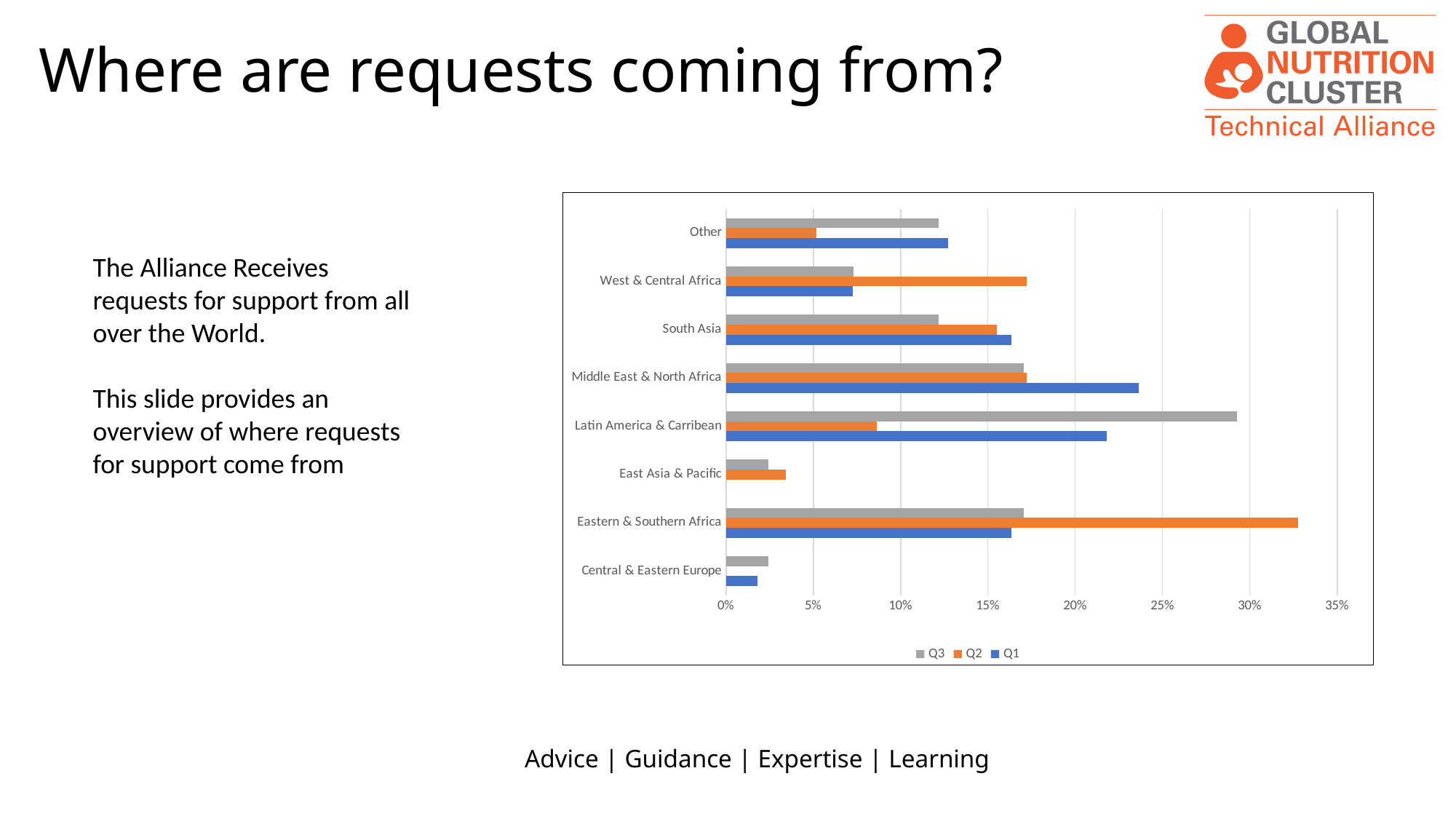
Is the Q1 value for Middle East & North Africa greater or less than 20%? greater Is the Q2 value for Eastern & Southern Africa greater or less than 30%? greater Which region has the highest Q1 value? Middle East & North Africa Which region has the highest Q3 value? Latin America & Carribean Is the Q3 value for Latin America & Carribean greater or less than 25%? greater For Other, which is larger: the Q1 value or the Q2 value? Q1 What are the entries listed in the chart's legend? Q3, Q2, Q1 How many series does the chart's legend list? 3 How many regions (categories) are listed on the chart? 8 For West & Central Africa, which is larger: the Q2 value or the Q3 value? Q2 Which region has the highest Q2 value? Eastern & Southern Africa What kind of chart is shown on the slide? Bar chart